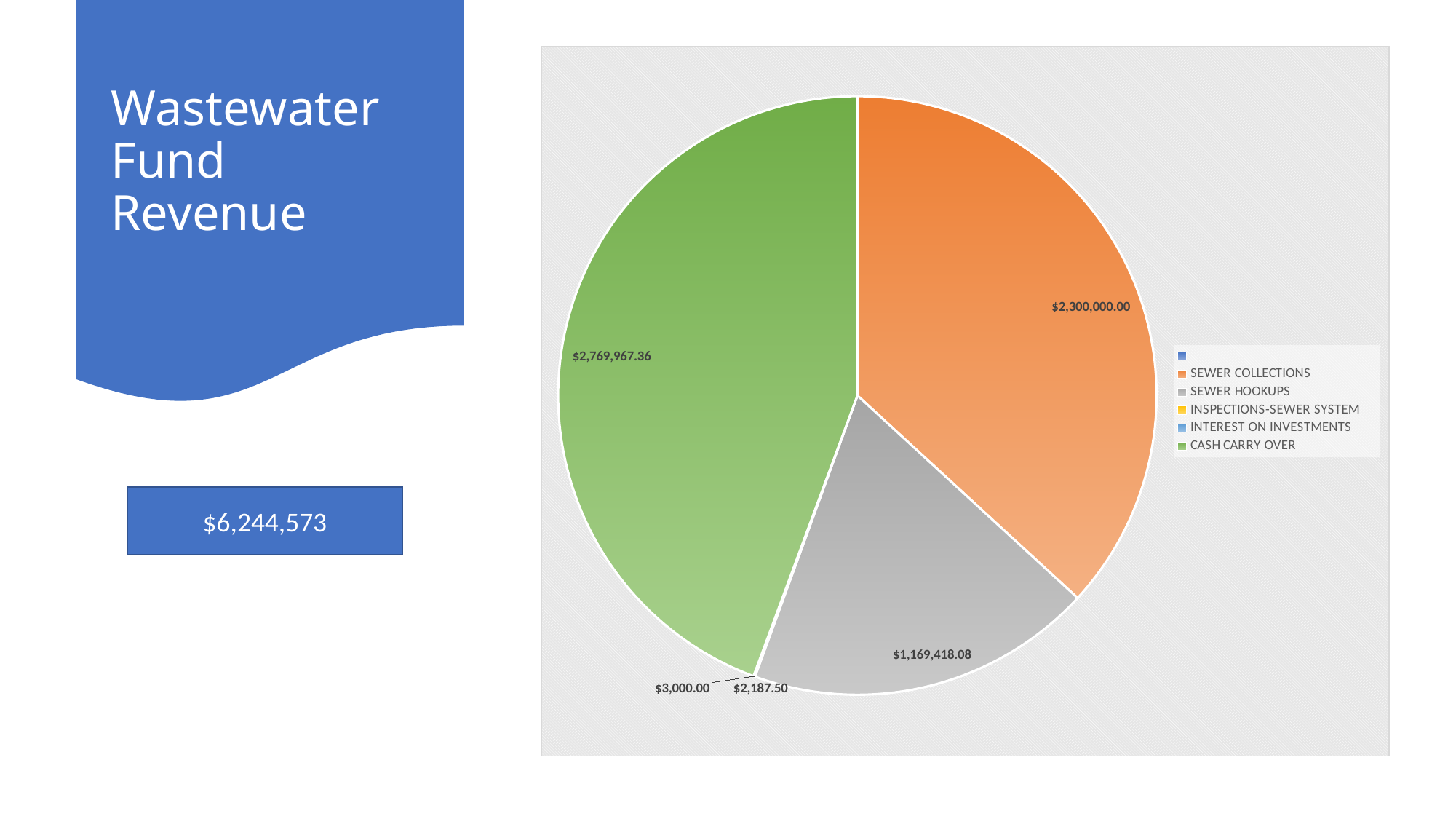
What is the value of the CASH CARRY OVER slice? $2,769,967.36 Which is larger, CASH CARRY OVER or SEWER COLLECTIONS? CASH CARRY OVER What is the value of the SEWER HOOKUPS slice? $1,169,418.08 What colour is the SEWER HOOKUPS slice? gray How many data labels are printed on the pie chart? 5 Which category has the largest slice of the pie? CASH CARRY OVER What is the difference between the SEWER COLLECTIONS value and the SEWER HOOKUPS value? $1,130,581.92 What type of chart is shown on the slide? pie chart What total revenue figure is shown in the box on the left of the slide? $6,244,573 What is the difference between the CASH CARRY OVER value and the SEWER COLLECTIONS value? $469,967.36 What is the value of the SEWER COLLECTIONS slice? $2,300,000.00 Which is larger, SEWER COLLECTIONS or SEWER HOOKUPS? SEWER COLLECTIONS